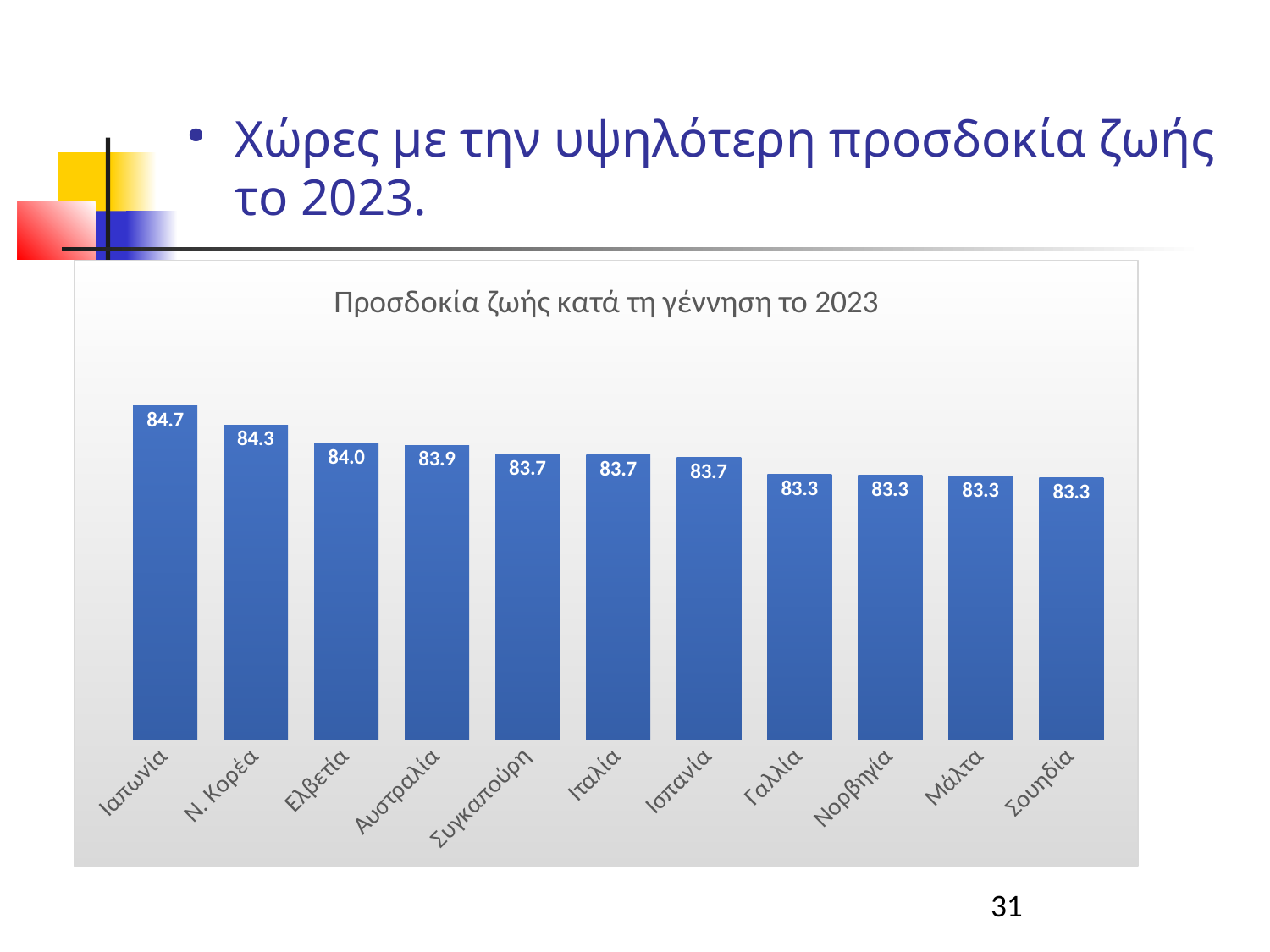
What value is shown for Ν. Κορέα? 84.3 What value is shown for Αυστραλία? 83.9 Which country has the highest value in the chart? Ιαπωνία What is the life expectancy value shown for Ιαπωνία? 84.7 What is the difference between the values for Ιαπωνία and Γαλλία? 1.4 What value is shown for Ελβετία? 84.0 What value is shown for Σουηδία? 83.3 What kind of chart is shown on the slide? Bar chart How many countries are shown in the chart? 11 Which has the larger value, Ελβετία or Ιταλία? Ελβετία What is the difference between the values for Ιαπωνία and Ν. Κορέα? 0.4 What is the title of the chart? Προσδοκία ζωής κατά τη γέννηση το 2023